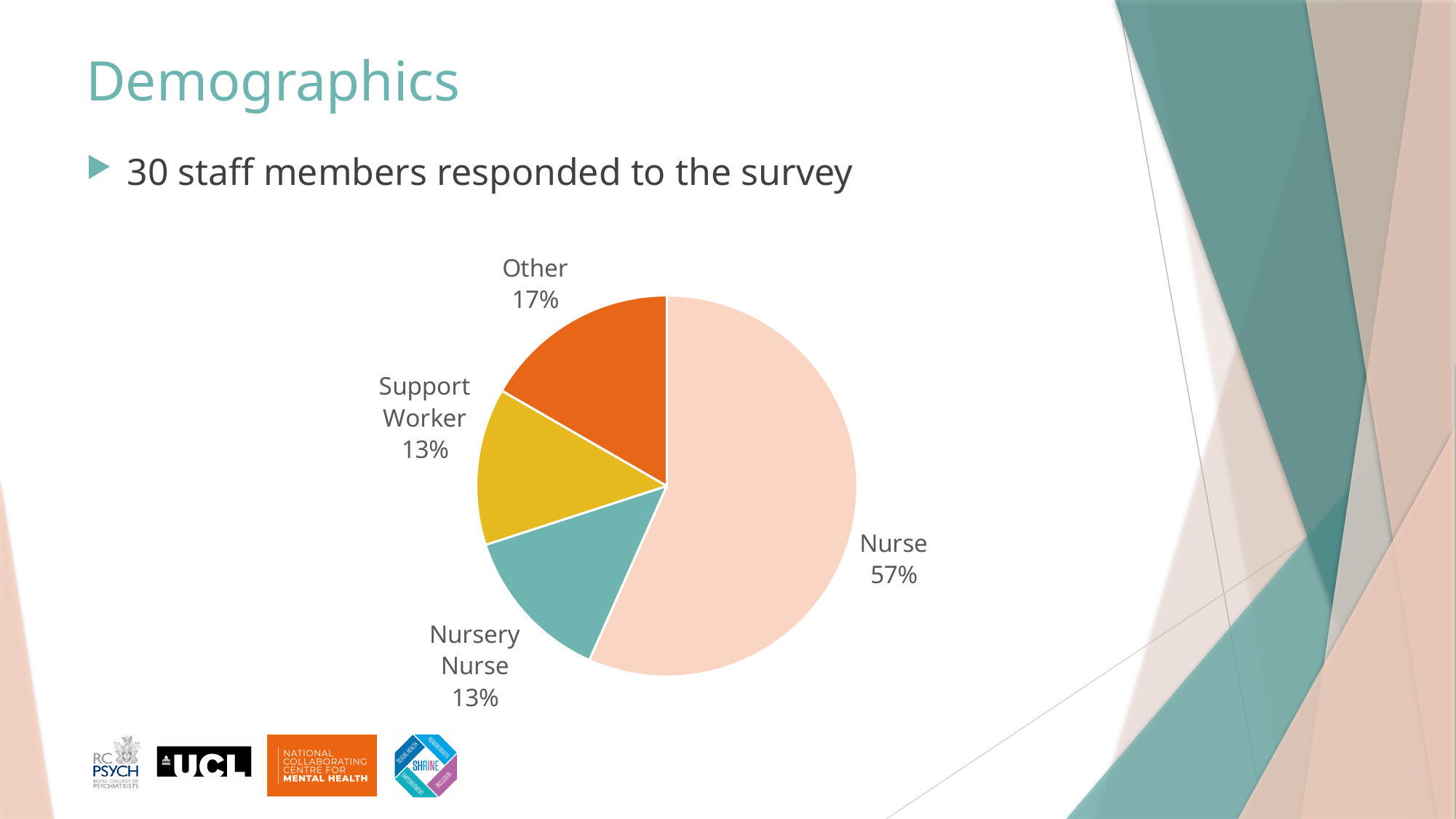
How many staff members responded to the survey, according to the slide? 30 What percentage of respondents are Support Workers? 13% What percentage of respondents are Nursery Nurses? 13% What percentage of respondents are in the Other category? 17% What percentage of respondents are Nurses? 57% What is the difference in percentage points between the Other and Nursery Nurse slices? 4 What is the difference in percentage points between the Nurse and Other slices? 40 What colour is the Nursery Nurse slice? teal Which is larger, the Other slice or the Support Worker slice? Other Which category has the largest share of the pie? Nurse How many categories are shown in the pie chart? 4 What kind of chart is shown on the slide? pie chart